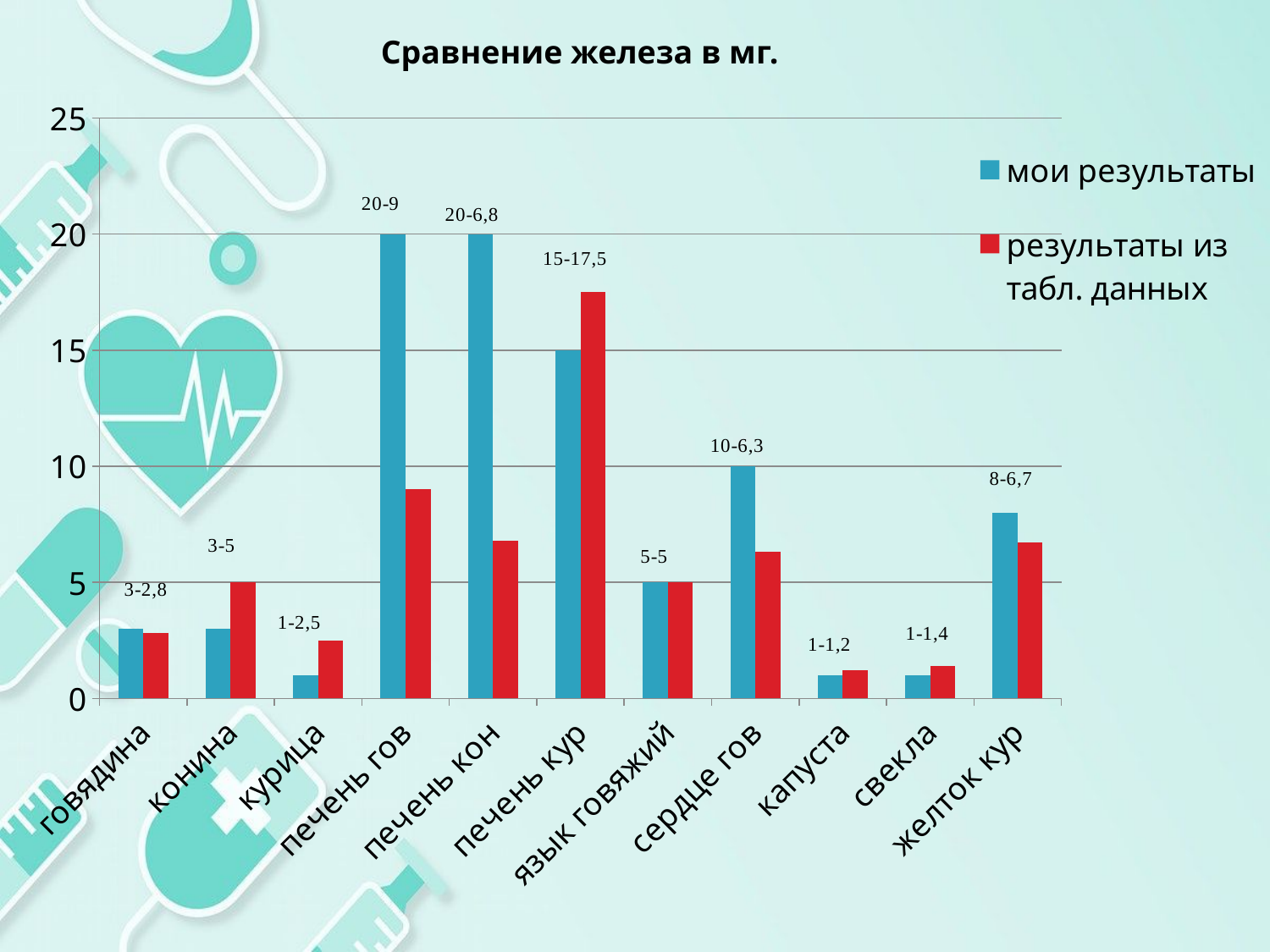
Is the value of 'мои результаты' for сердце гов greater or less than 5? greater Which colour represents the series 'мои результаты' in the legend? blue How many series does the legend list? 2 What is the data label shown above the bars for желток кур? 8-6,7 What kind of chart is shown on the slide? bar chart Which category has the highest value for the series 'результаты из табл. данных'? печень кур What is the data label shown above the bars for печень гов? 20-9 For печень кур, which series has the larger value: 'мои результаты' or 'результаты из табл. данных'? результаты из табл. данных What is the data label shown above the bars for язык говяжий? 5-5 What is the title of the chart? Сравнение железа в мг. For печень кон, which series has the larger value: 'мои результаты' or 'результаты из табл. данных'? мои результаты How many categories are shown on the x axis? 11